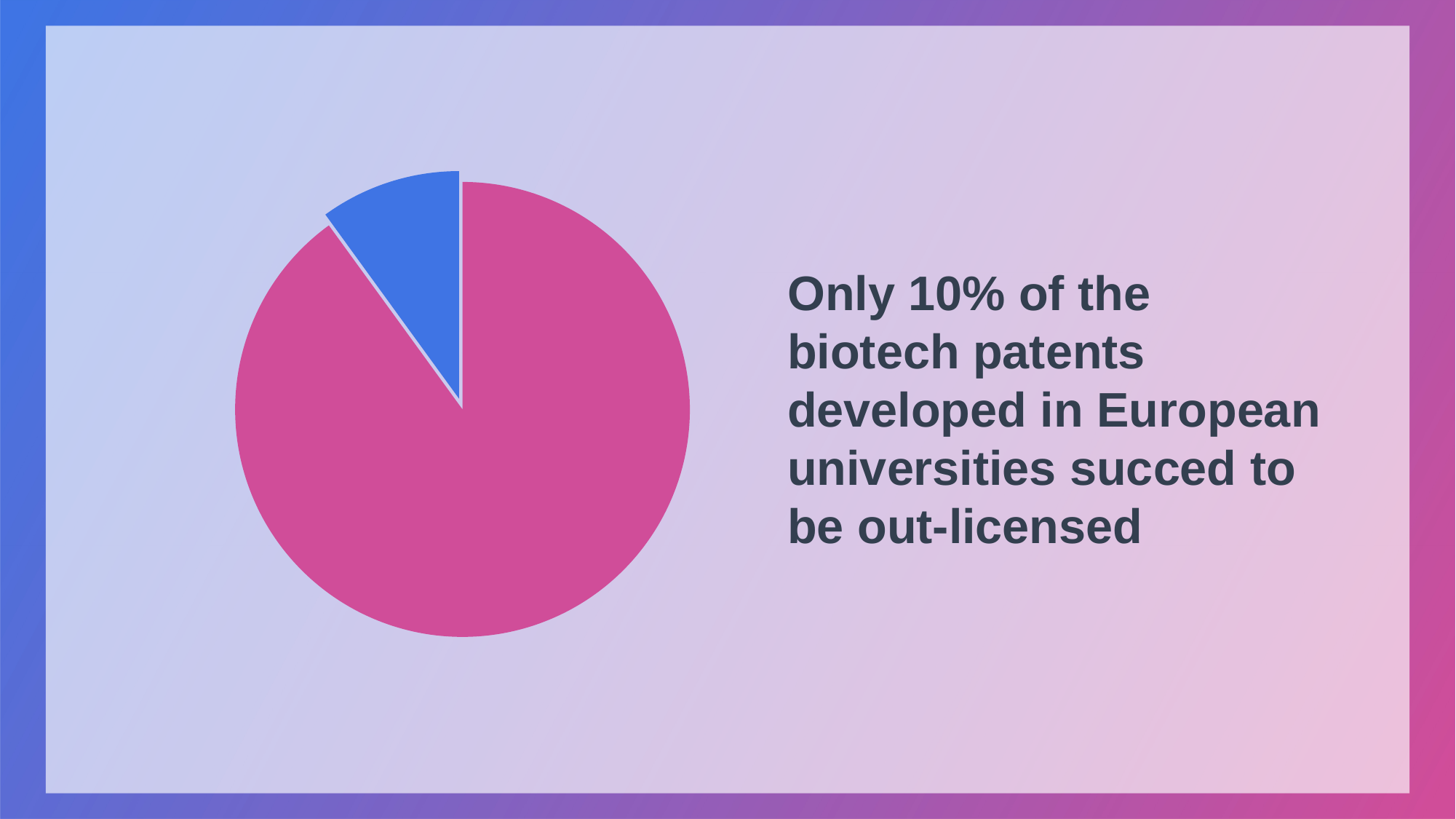
Which slice of the pie chart is the smallest? the blue slice What colour is the larger slice of the pie chart? pink Does the pie chart have a legend? No According to the slide text, what share of the pie does the small blue slice represent? 10% Which slice of the pie chart is the largest? the pink slice Which slice of the pie chart is larger, the pink one or the blue one? the pink one What kind of chart is shown on the slide? pie chart How many slices does the pie chart have? 2 Based on the 10% stated on the slide, what share of the pie does the large pink slice represent? 90%